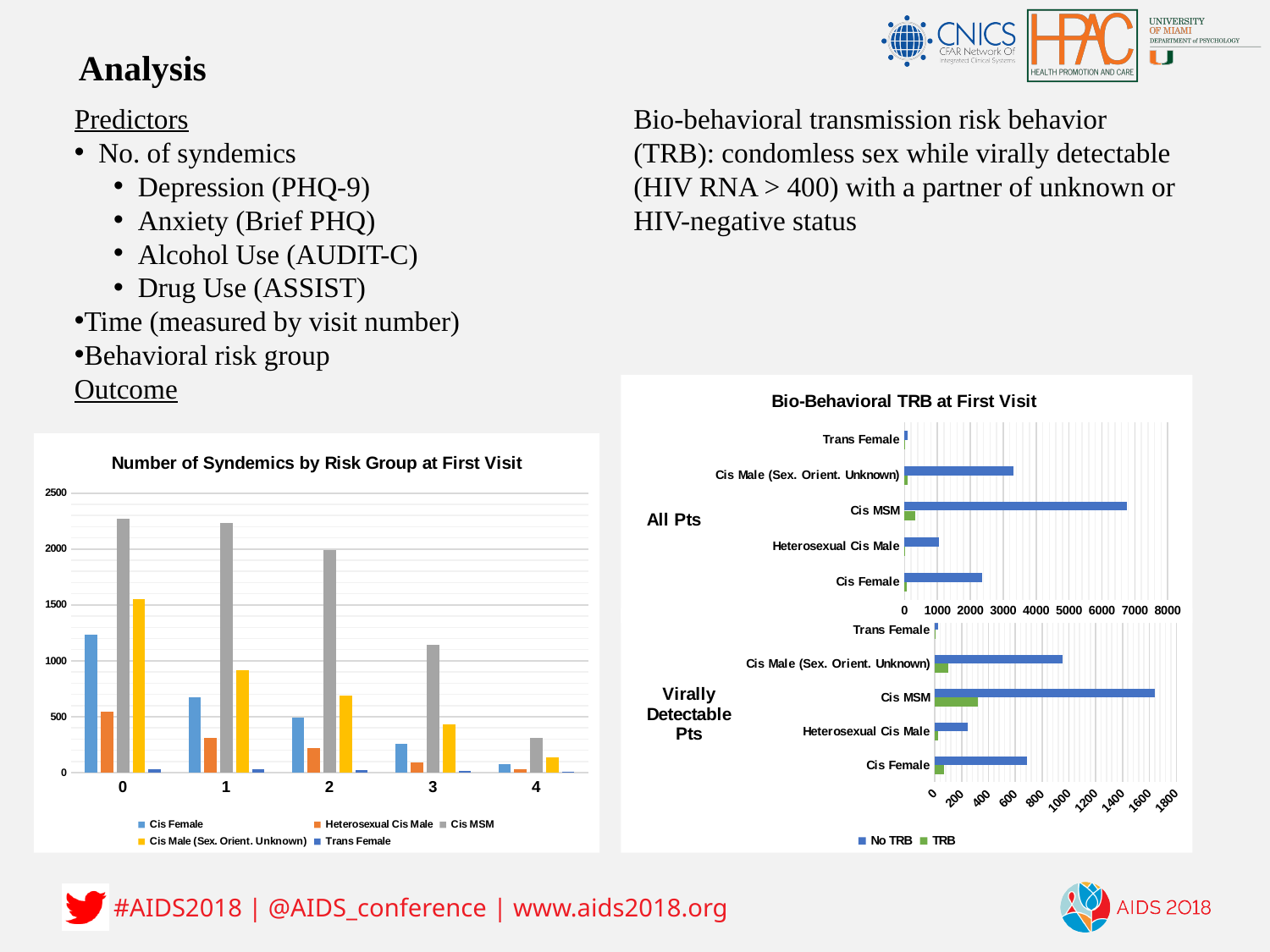
What kind of chart is the 'Number of Syndemics by Risk Group at First Visit' chart? bar chart In the 'Bio-Behavioral TRB at First Visit' chart, is the No TRB value for Cis MSM among Virally Detectable Pts greater or less than 1400? greater In the 'Number of Syndemics by Risk Group at First Visit' chart, do the Cis MSM bars rise or fall as the number of syndemics goes from 0 to 4? fall In the 'Number of Syndemics by Risk Group at First Visit' chart, which risk group has the tallest bar at 0 syndemics? Cis MSM In the 'Number of Syndemics by Risk Group at First Visit' chart, at 1 syndemic, which is larger: Cis Female or Cis Male (Sex. Orient. Unknown)? Cis Male (Sex. Orient. Unknown) In the 'Number of Syndemics by Risk Group at First Visit' chart, is the value for Cis MSM at 0 syndemics greater or less than 2000? greater In the 'Number of Syndemics by Risk Group at First Visit' chart, is the value for Cis Female at 0 syndemics greater or less than 1000? greater In the 'Number of Syndemics by Risk Group at First Visit' chart, how many risk groups does the legend list? 5 In the 'Bio-Behavioral TRB at First Visit' chart, which group has the longest No TRB bar among All Pts? Cis MSM In the 'Number of Syndemics by Risk Group at First Visit' chart, how many syndemic-count categories are shown on the x axis? 5 In the 'Bio-Behavioral TRB at First Visit' chart, how many series does the legend list? 2